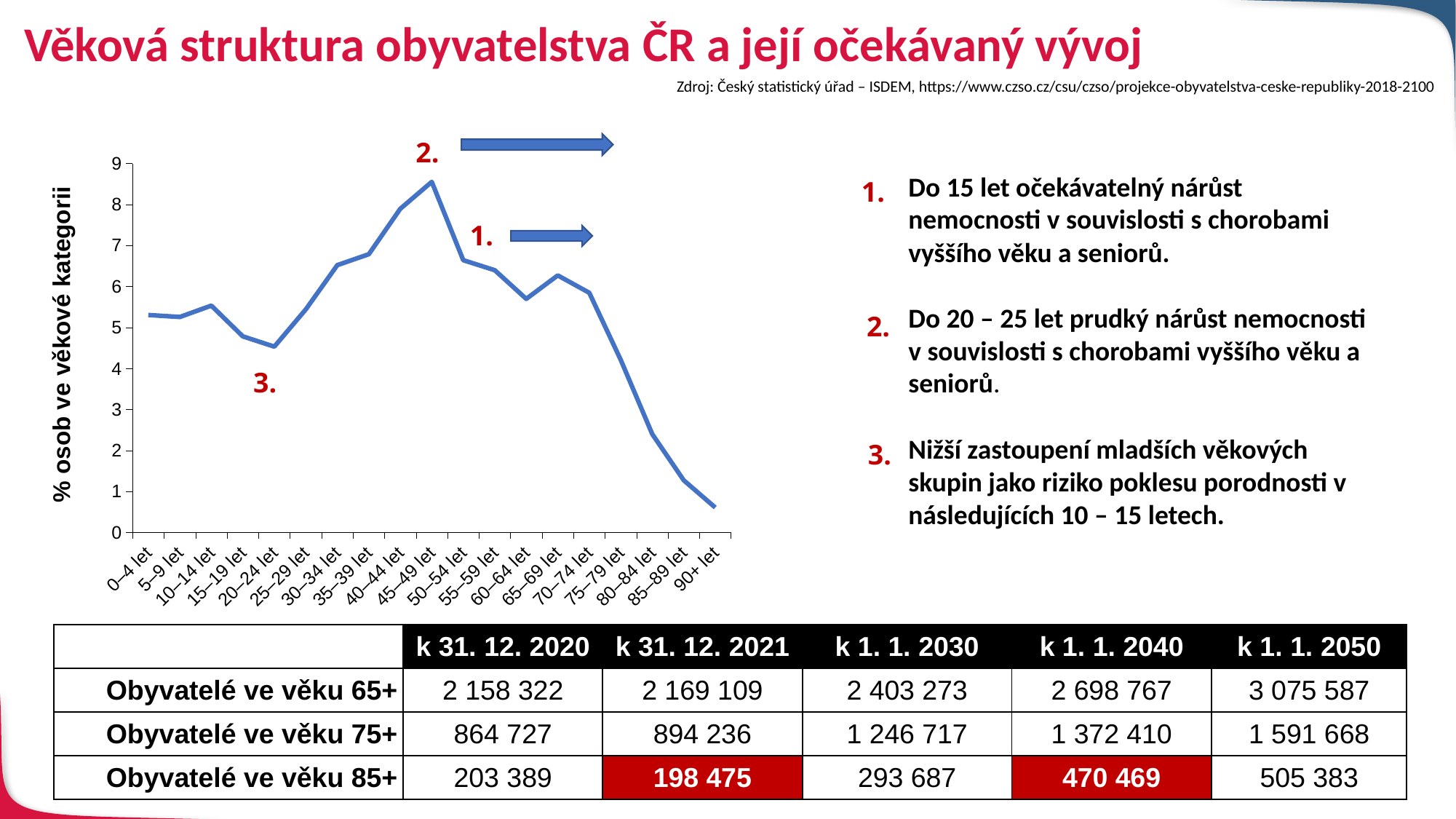
What kind of chart is shown on the slide? line chart Is the value for 90+ let greater or less than 1? less How many age categories are plotted along the x axis of the chart? 19 Which age category has the highest value in the chart? 45–49 let Is the value for 80–84 let greater or less than 3? less Which has the larger value, 0–4 let or 90+ let? 0–4 let Is the value for 45–49 let greater or less than 8? greater Which age category has the lowest value in the chart? 90+ let What is the title of the vertical axis of the chart? % osob ve věkové kategorii Which has the larger value, 40–44 let or 60–64 let? 40–44 let Do the values rise or fall along the x axis from 45–49 let to 90+ let? fall